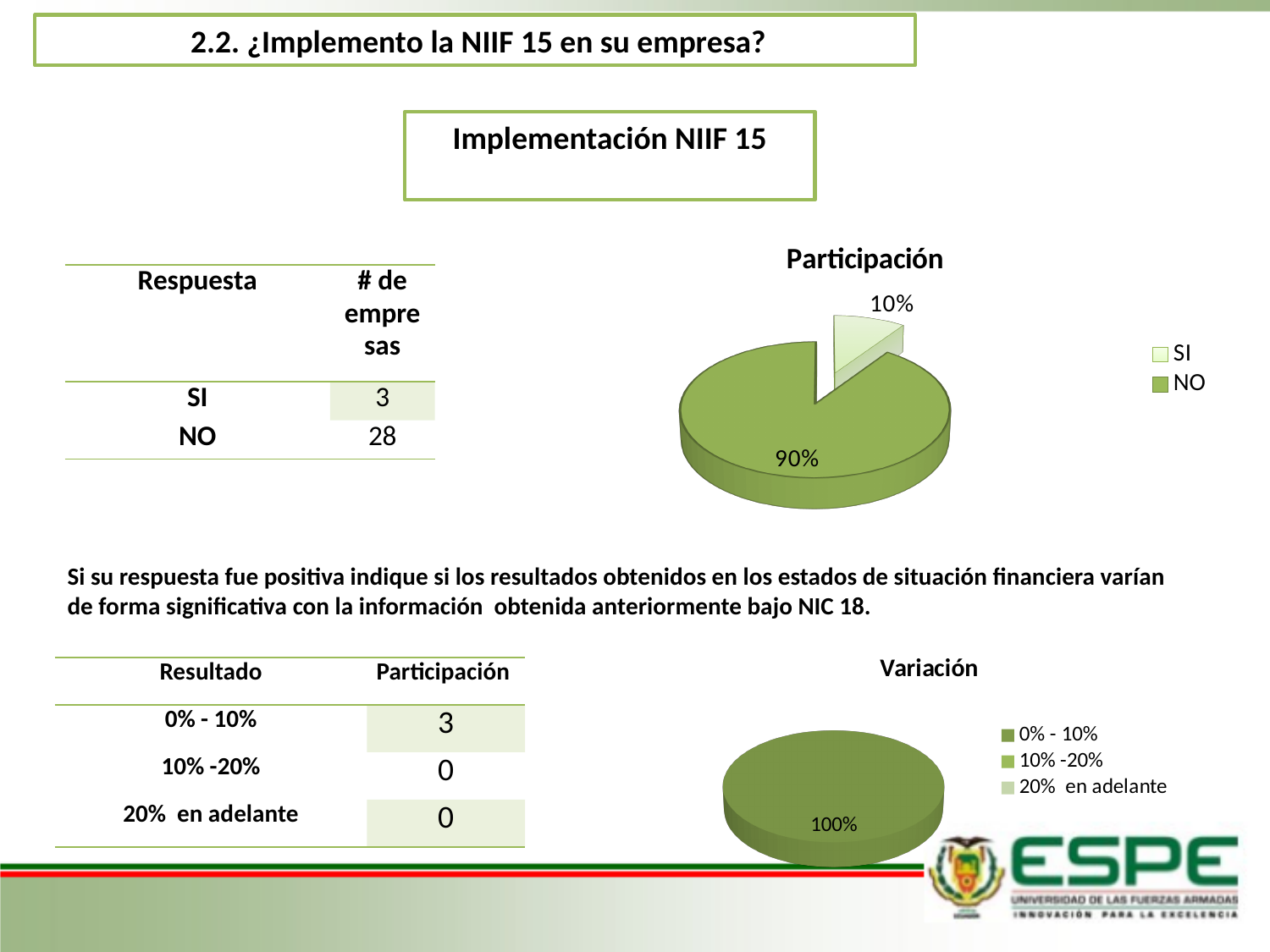
In the 'Participación' chart, which category has the largest slice? NO In the 'Participación' chart, what share of the pie does the 'SI' slice represent? 10% What is the title of the pie chart in the lower right of the slide? Variación How many entries does the legend of the 'Variación' chart list? 3 In the 'Participación' chart, which category has the smallest slice? SI In the 'Variación' chart, what share of the pie is shown by the data label? 100% In the 'Participación' chart, what is the difference in percentage points between the 'NO' and 'SI' slices? 80 What kind of chart is the 'Variación' chart? Pie chart In the 'Participación' chart, what share of the pie does the 'NO' slice represent? 90% What kind of chart is the 'Participación' chart? Pie chart In the 'Participación' chart, which slice is larger, 'SI' or 'NO'? NO How many entries does the legend of the 'Participación' chart list? 2